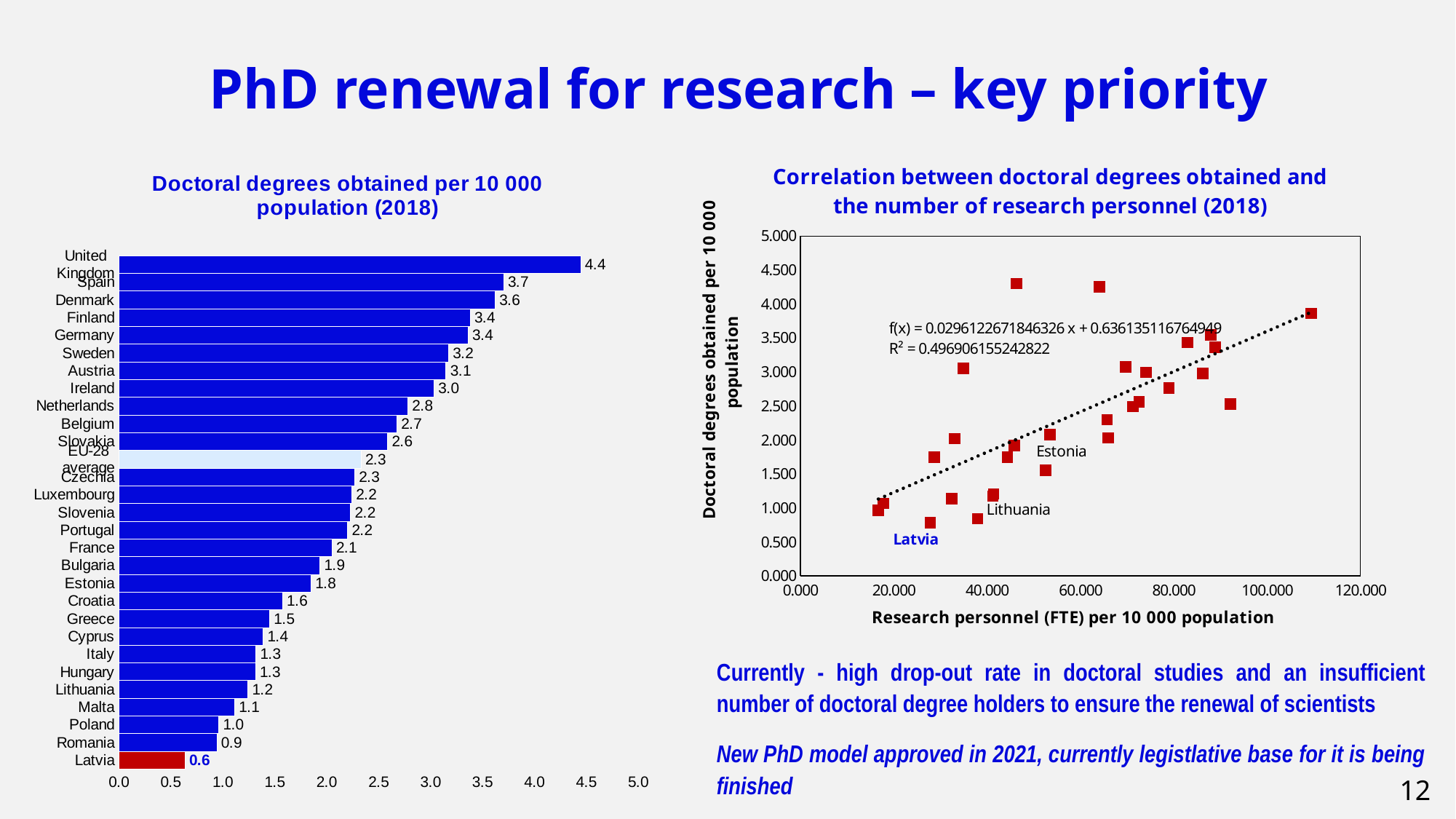
How many bars are shown in the 'Doctoral degrees obtained per 10 000 population (2018)' chart? 29 In the 'Doctoral degrees obtained per 10 000 population (2018)' chart, which country has the highest value? United Kingdom In the 'Doctoral degrees obtained per 10 000 population (2018)' chart, which country has the lowest value? Latvia In the 'Doctoral degrees obtained per 10 000 population (2018)' chart, what is the value for Spain? 3.7 In the 'Doctoral degrees obtained per 10 000 population (2018)' chart, what is the value for Latvia? 0.6 In the 'Doctoral degrees obtained per 10 000 population (2018)' chart, what is the value for the EU-28 average? 2.3 In the 'Doctoral degrees obtained per 10 000 population (2018)' chart, which has a higher value, Estonia or Lithuania? Estonia What type of chart is 'Doctoral degrees obtained per 10 000 population (2018)'? Bar chart In the 'Correlation between doctoral degrees obtained and the number of research personnel (2018)' chart, is the doctoral degrees value for Latvia greater or less than 1.000? less In the 'Doctoral degrees obtained per 10 000 population (2018)' chart, what is the difference between the United Kingdom and Latvia? 3.8 What type of chart is 'Correlation between doctoral degrees obtained and the number of research personnel (2018)'? Scatter chart In the 'Doctoral degrees obtained per 10 000 population (2018)' chart, which bar is coloured red? Latvia